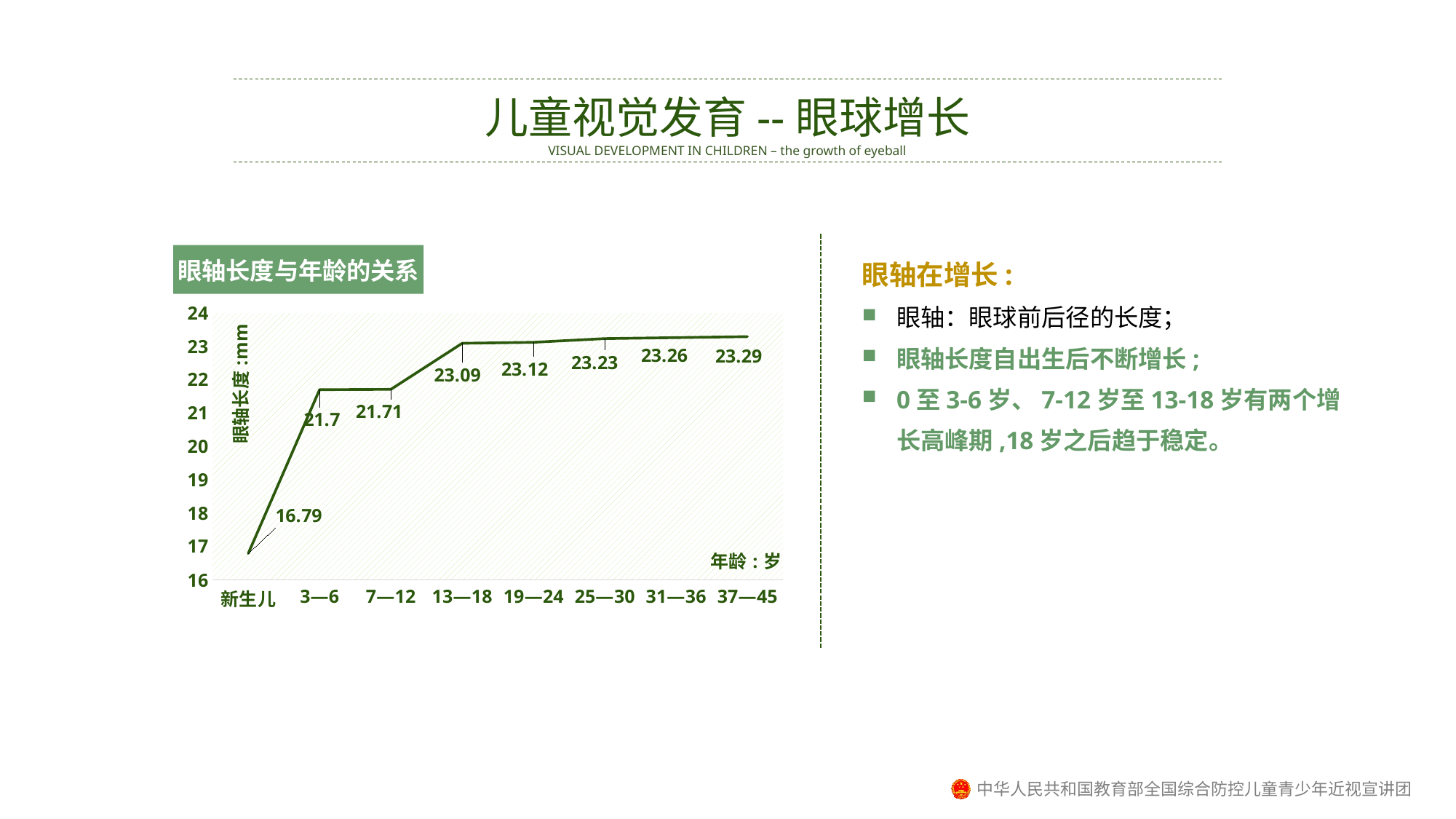
What is the axial length value for the 13—18 age group? 23.09 What is the title of the chart? 眼轴长度与年龄的关系 What is the axial length value for the 3—6 age group? 21.7 How many age categories are plotted on the x axis? 8 What is the axial length value for 新生儿 (newborn)? 16.79 What is the axial length value for the 37—45 age group? 23.29 What type of chart is shown on the slide? line chart Which is larger, the axial length for 13—18 or for 7—12? 13—18 Which age group has the highest axial length? 37—45 What is the difference in axial length between the 3—6 group and 新生儿? 4.91 Which age group has the lowest axial length? 新生儿 Do the axial length values rise or fall from 新生儿 to 37—45? rise